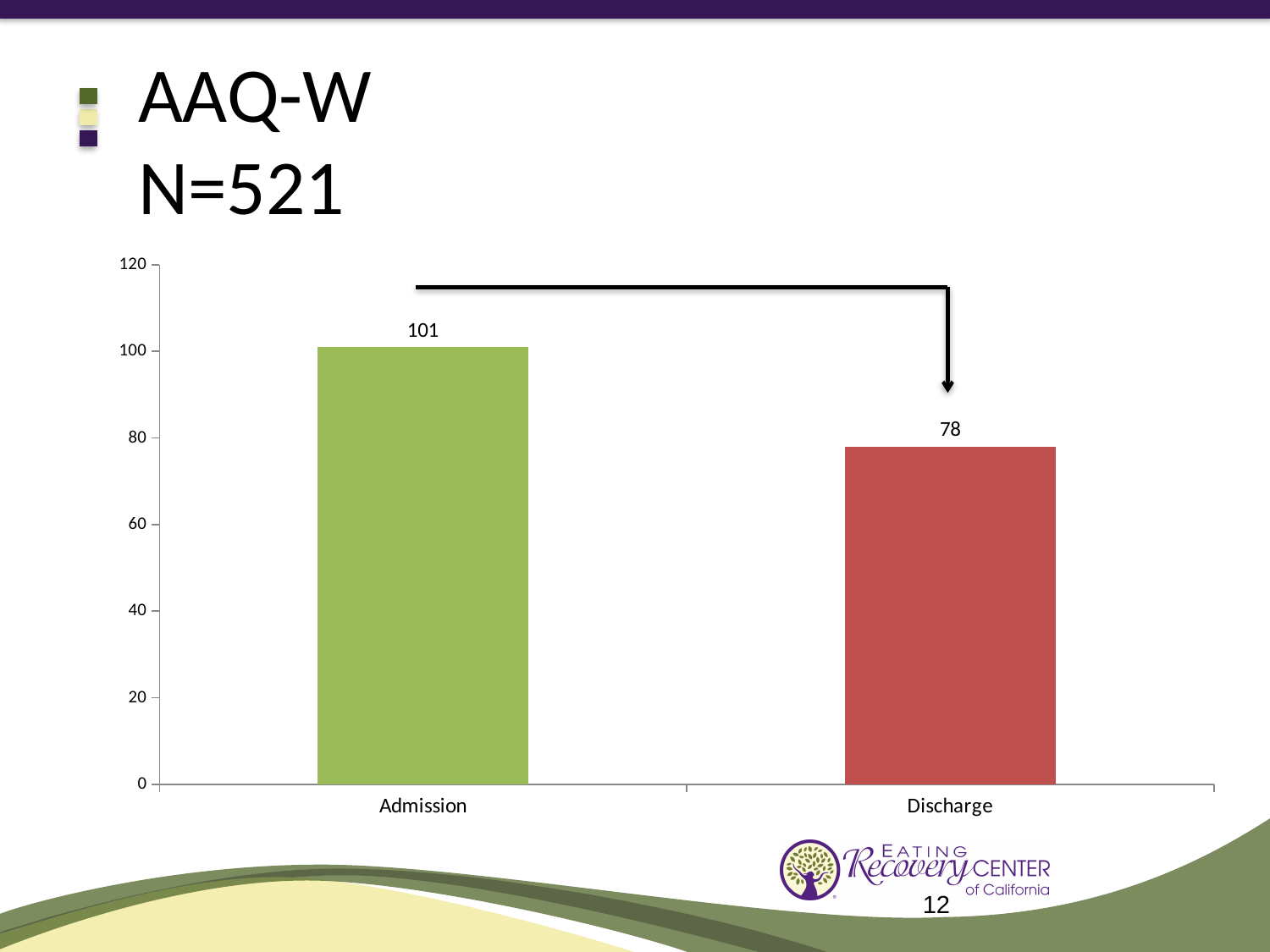
Which is larger, the value for Admission or the value for Discharge? Admission Is the value for Admission greater or less than 100? greater What is the value for Discharge? 78 How many categories are shown on the x axis? 2 Is the value for Discharge greater or less than 80? less What is the value for Admission? 101 What kind of chart is shown on the slide? bar chart Which category has the highest value? Admission What is the difference between the Admission and Discharge values? 23 Which category has the lowest value? Discharge What colour is the Discharge bar? red Do the values rise or fall from Admission to Discharge? fall